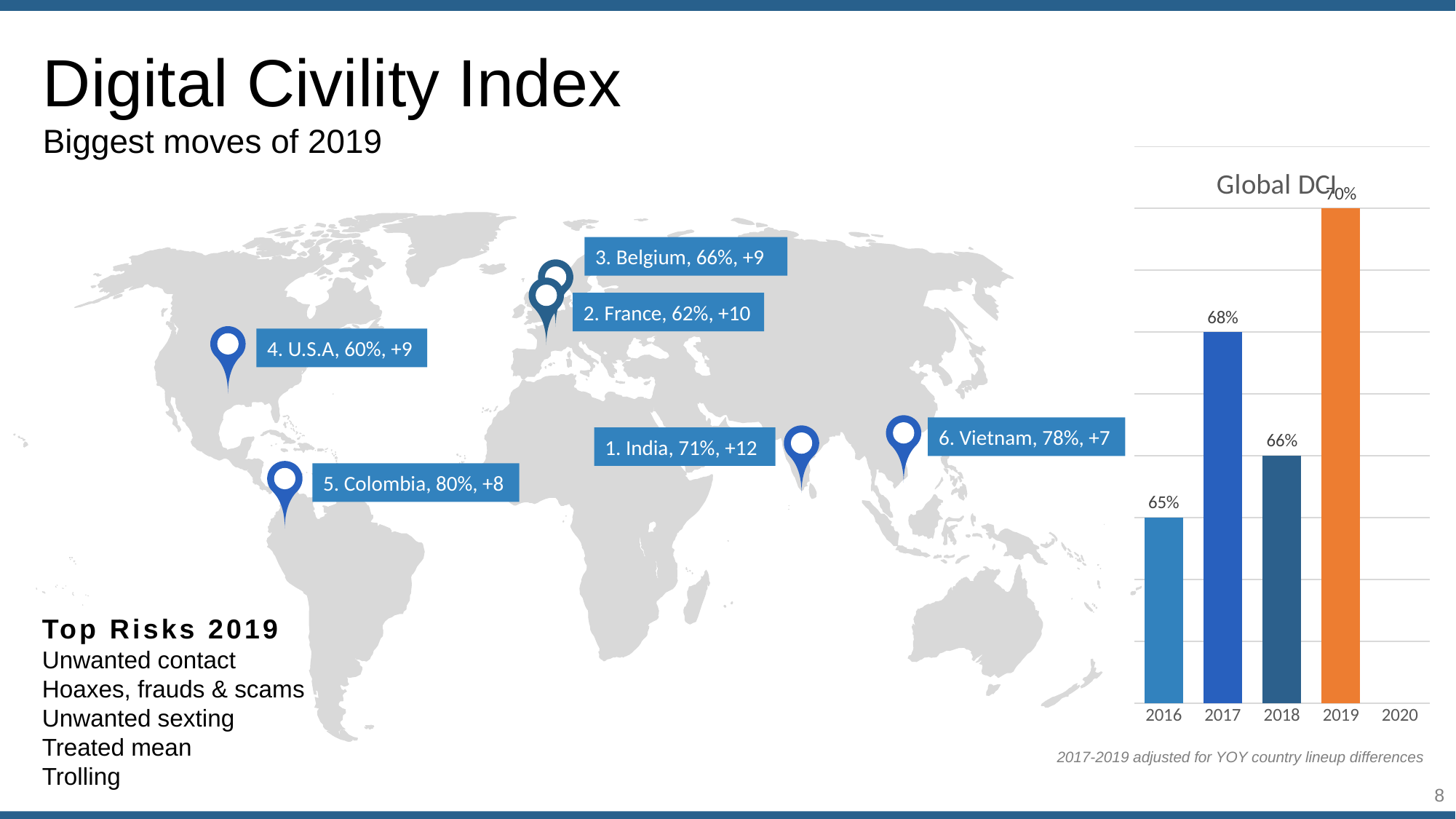
What is the title of the bar chart on the right of the slide? Global DCI In the Global DCI chart, does the value rise or fall from 2018 to 2019? rise In the Global DCI chart, which year has the lowest value? 2016 In the Global DCI chart, which year has the highest value? 2019 In the Global DCI chart, what is the value for 2019? 70% In the Global DCI chart, what is the value for 2016? 65% In the Global DCI chart, which year has the larger value, 2017 or 2018? 2017 In the Global DCI chart, what is the value for 2017? 68% What type of chart is the Global DCI chart? bar chart In the Global DCI chart, what is the value for 2018? 66% In the Global DCI chart, what is the difference between the 2019 and 2016 values? 5% How many bars are plotted in the Global DCI chart? 4